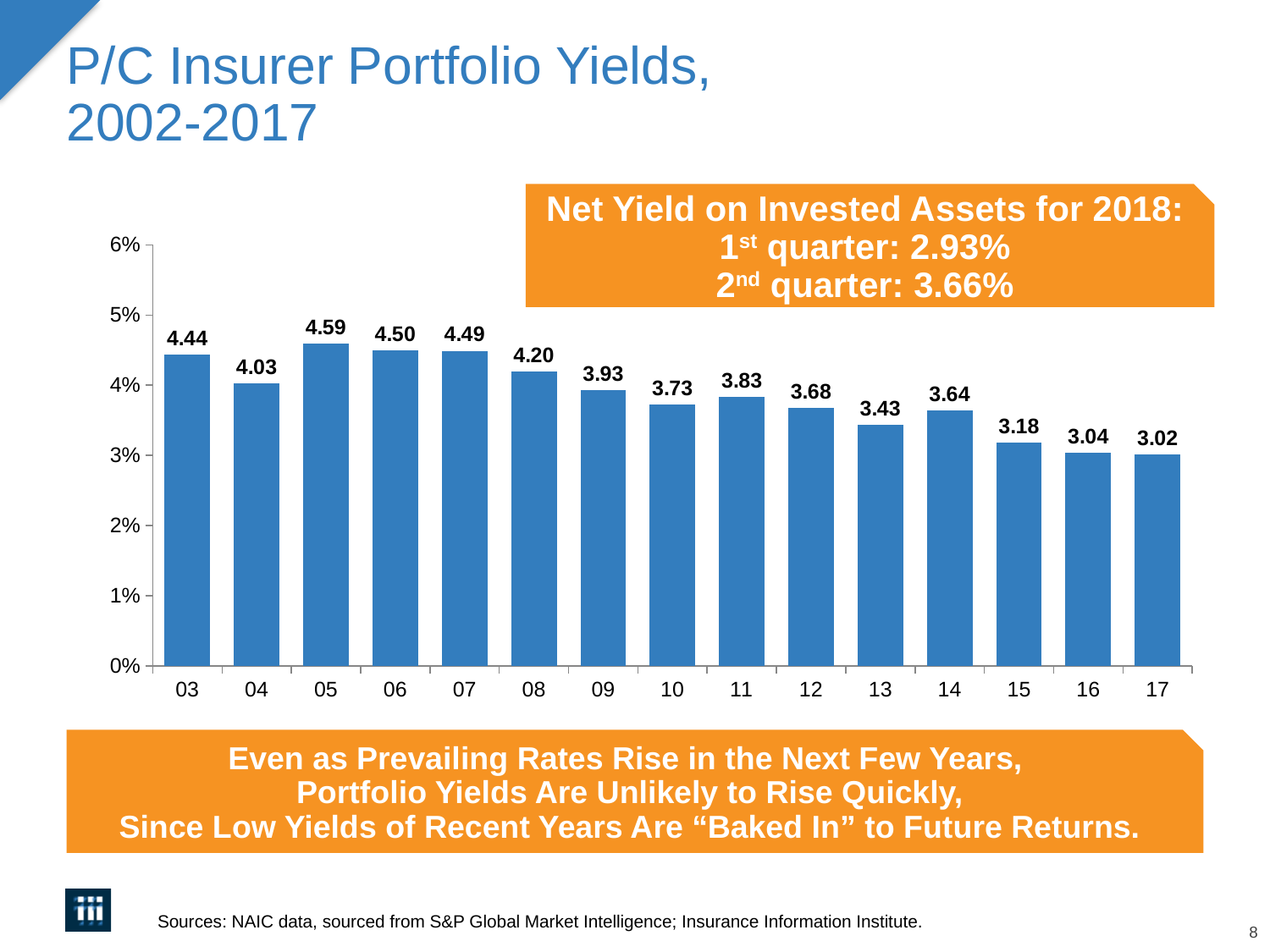
What is the difference between the yield for 03 and the yield for 04? 0.41 What is the difference between the yield for 05 and the yield for 17? 1.57 Which year has the lowest portfolio yield? 17 What is the portfolio yield shown for 05? 4.59 Which is larger, the yield for 10 or the yield for 11? 11 How many years (bars) are plotted on the chart? 15 Is the value for 15 greater or less than 4%? less Do the portfolio yields generally rise or fall from 03 to 17? fall What is the portfolio yield shown for 13? 3.43 What kind of chart is shown on the slide? bar chart What is the portfolio yield shown for 17? 3.02 Which year has the highest portfolio yield? 05